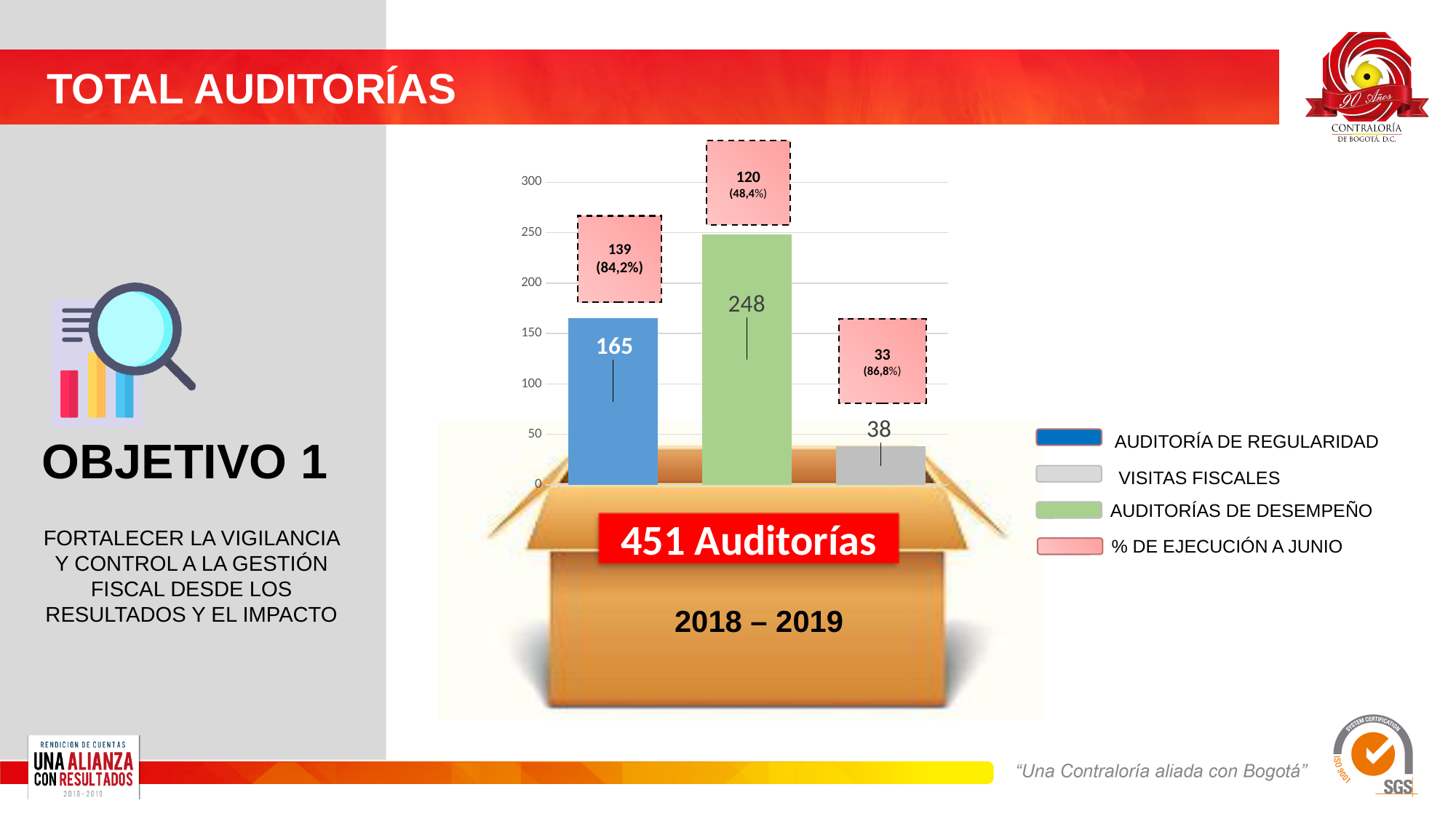
What is the value of the bar for Auditoría de Regularidad? 165 How many executed audits to June are shown for Auditoría de Regularidad? 139 What type of chart is shown on the slide? Bar chart What percentage of execution to June is shown for Auditorías de Desempeño? 48,4% How many entries does the legend list? 4 What total number of audits is shown on the chart? 451 Auditorías Which is larger, the bar for Auditoría de Regularidad or the bar for Visitas Fiscales? Auditoría de Regularidad What is the value of the bar for Visitas Fiscales? 38 What is the difference between the bars for Auditorías de Desempeño and Auditoría de Regularidad? 83 Which category has the lowest bar? Visitas Fiscales What is the value of the bar for Auditorías de Desempeño? 248 Which category has the highest bar? Auditorías de Desempeño